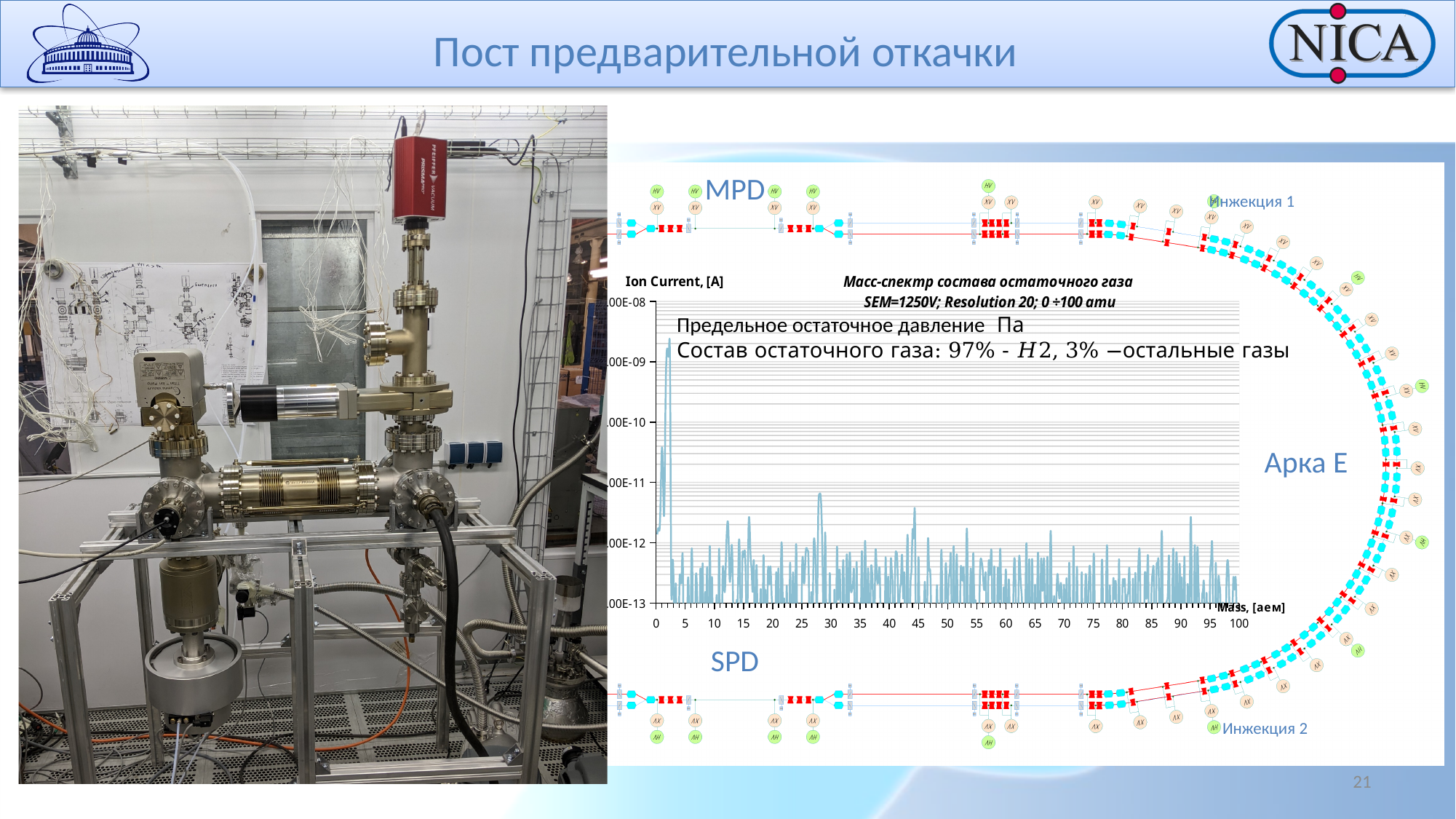
In the mass spectrum chart, is the ion current of the tallest peak greater or less than 1.00E-09 A? greater In the mass spectrum chart, is the ion current of the tallest peak greater or less than 1.00E-08 A? less What kind of chart is the mass spectrum on the slide? line chart In the mass spectrum chart, is the tallest peak located at a mass greater or less than 5 аем? less In the mass spectrum chart, do the ion current values generally rise or fall after the main peak at low mass? fall What SEM voltage is stated in the title of the mass spectrum chart? 1250V What is the x-axis label of the mass spectrum chart? Mass, [аем] In the mass spectrum chart, which peak is larger: the one near mass 2 or the one near mass 28? the one near mass 2